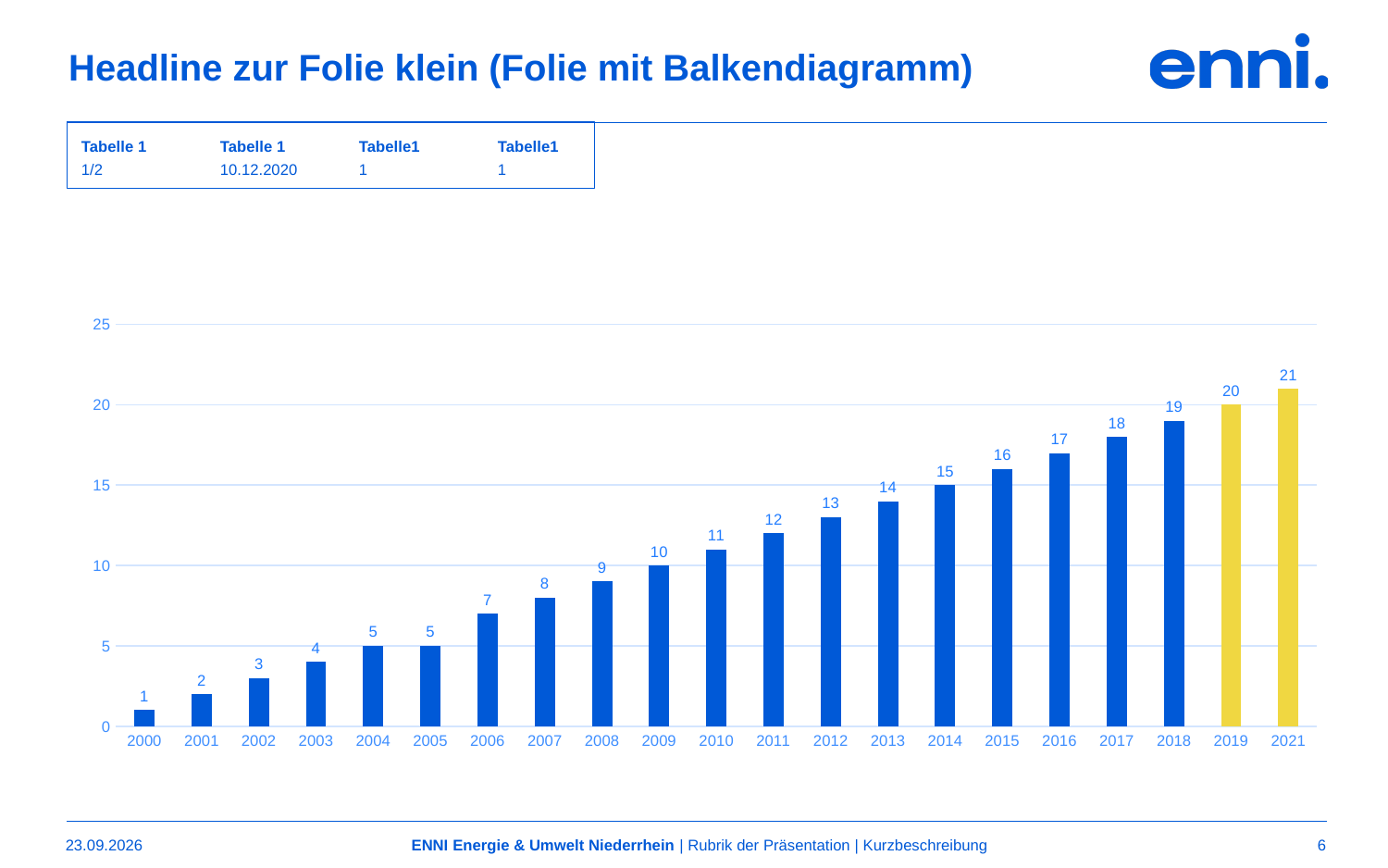
Is the value for 2017 greater or less than 15? greater What is the value for 2005? 5 What kind of chart is shown on the slide? bar chart Do the values rise or fall from 2000 to 2021? rise Which is larger, the value for 2013 or the value for 2016? 2016 Which years are shown with yellow bars instead of blue? 2019 and 2021 Which year has the lowest value? 2000 How many bars are shown in the chart? 21 What is the value for 2010? 11 What is the value for 2021? 21 Which year has the highest value? 2021 What is the difference between the values for 2018 and 2008? 10